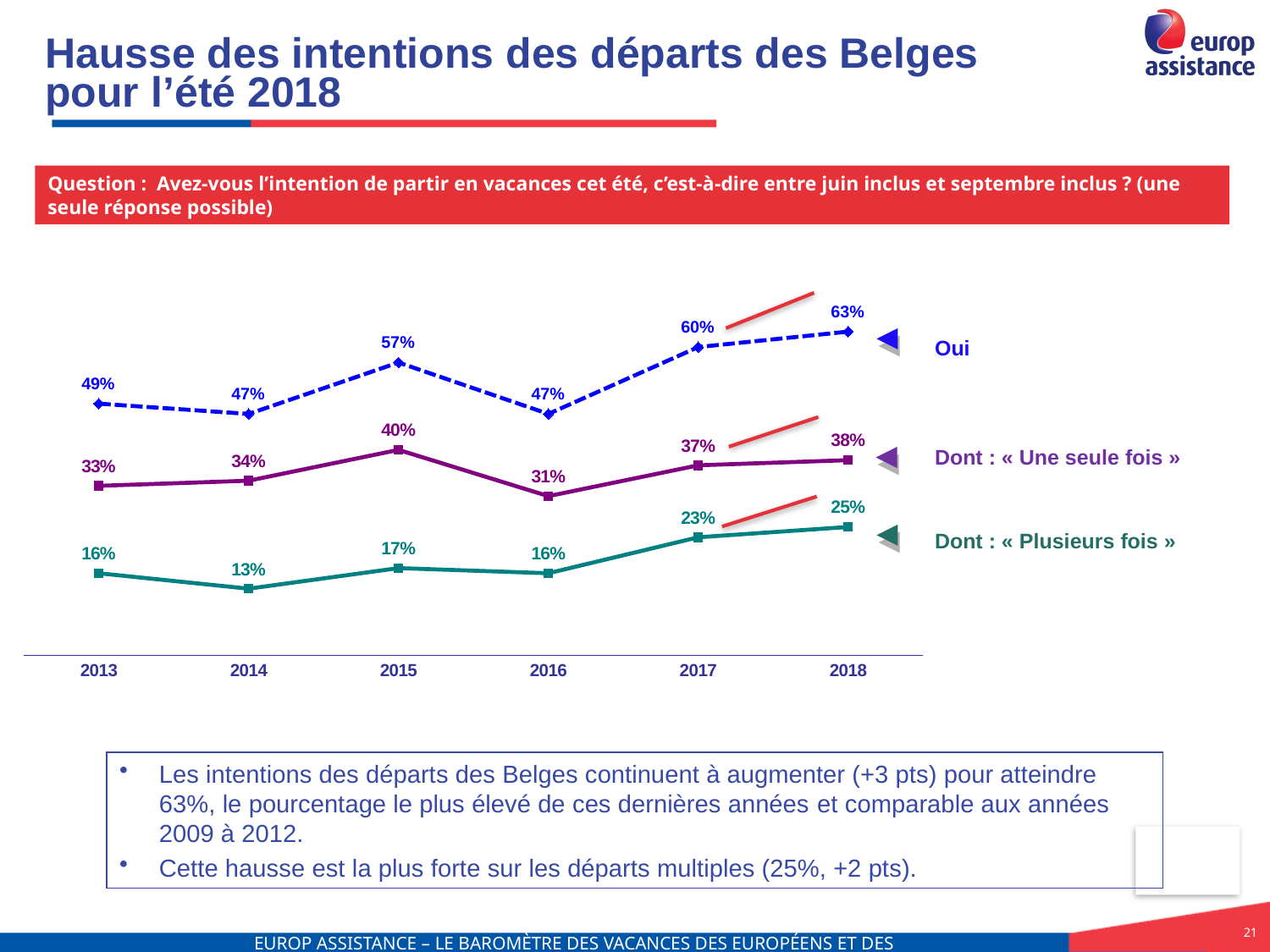
In which year is the "Dont : « Plusieurs fois »" series at its highest? 2018 What is the difference between the "Oui" values for 2018 and 2017? 3 points What is the value of the "Oui" series in 2018? 63% What is the value of the "Dont : « Plusieurs fois »" series in 2014? 13% In which year is the "Oui" series at its lowest? 2014 and 2016 (both 47%) What kind of chart is shown on the slide? Line chart Which is larger: the "Dont : « Une seule fois »" value in 2015 or in 2016? 2015 What is the value of the "Dont : « Une seule fois »" series in 2015? 40% Which series is drawn with a dashed line? Oui How many series are plotted on the chart? 3 How many years are shown on the x axis? 6 Does the "Oui" series rise or fall between 2016 and 2018? Rise